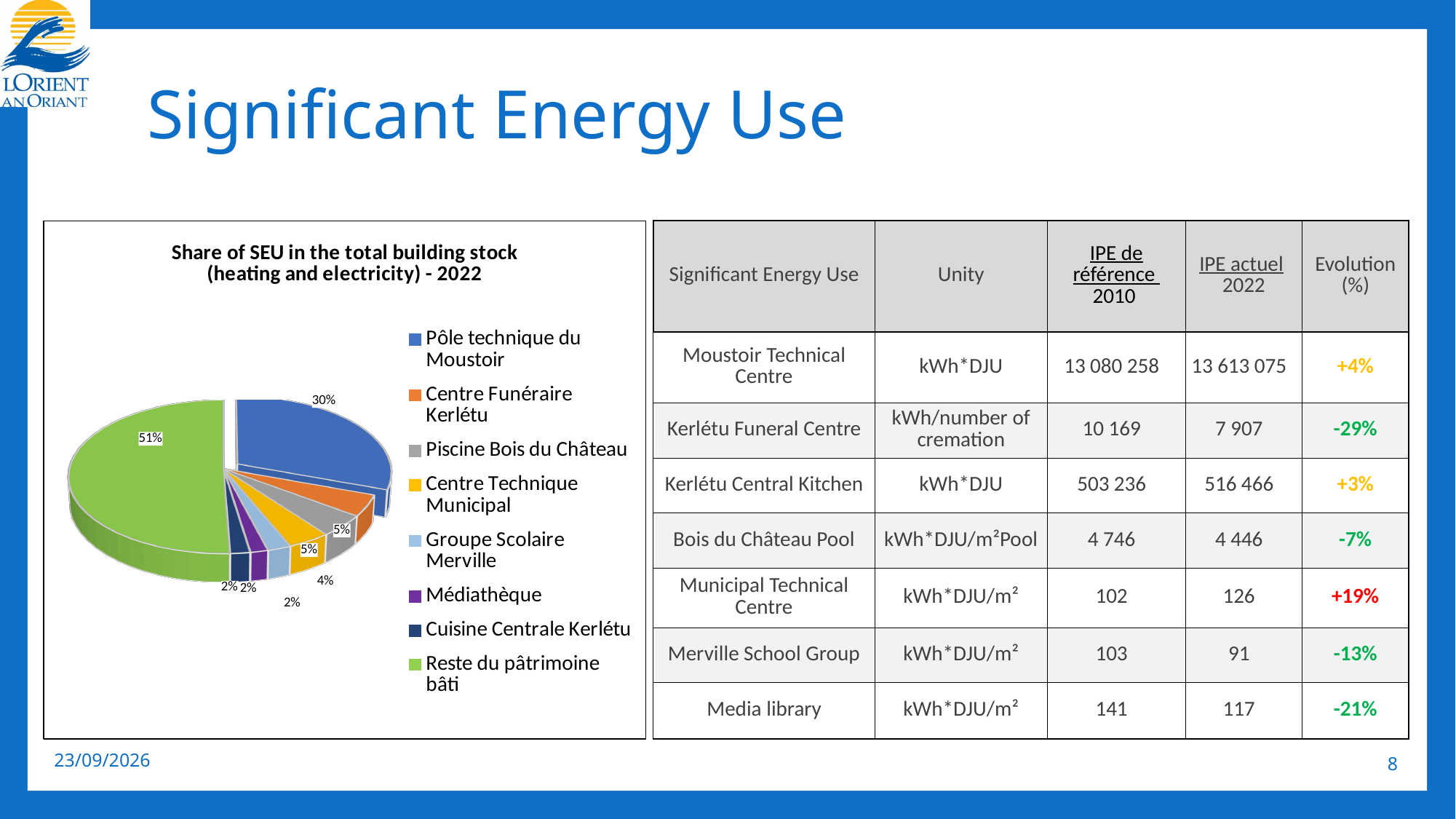
What share of SEU does 'Pôle technique du Moustoir' account for in the pie chart? 30% Which slice is larger: 'Pôle technique du Moustoir' or 'Reste du pâtrimoine bâti'? Reste du pâtrimoine bâti What kind of chart is shown on the slide? pie chart Which category has the largest slice in the pie chart? Reste du pâtrimoine bâti How many slices in the pie chart are labelled 2%? 3 How many slices in the pie chart are labelled 5%? 2 By how many percentage points does the 'Reste du pâtrimoine bâti' slice exceed the 'Pôle technique du Moustoir' slice? 21 percentage points What colour is the 'Reste du pâtrimoine bâti' slice in the pie chart? green What is the combined share of the two largest slices, 'Reste du pâtrimoine bâti' and 'Pôle technique du Moustoir'? 81% How many categories does the legend of the pie chart list? 8 What share of SEU does 'Reste du pâtrimoine bâti' account for in the pie chart? 51% What is the title of the pie chart? Share of SEU in the total building stock (heating and electricity) - 2022